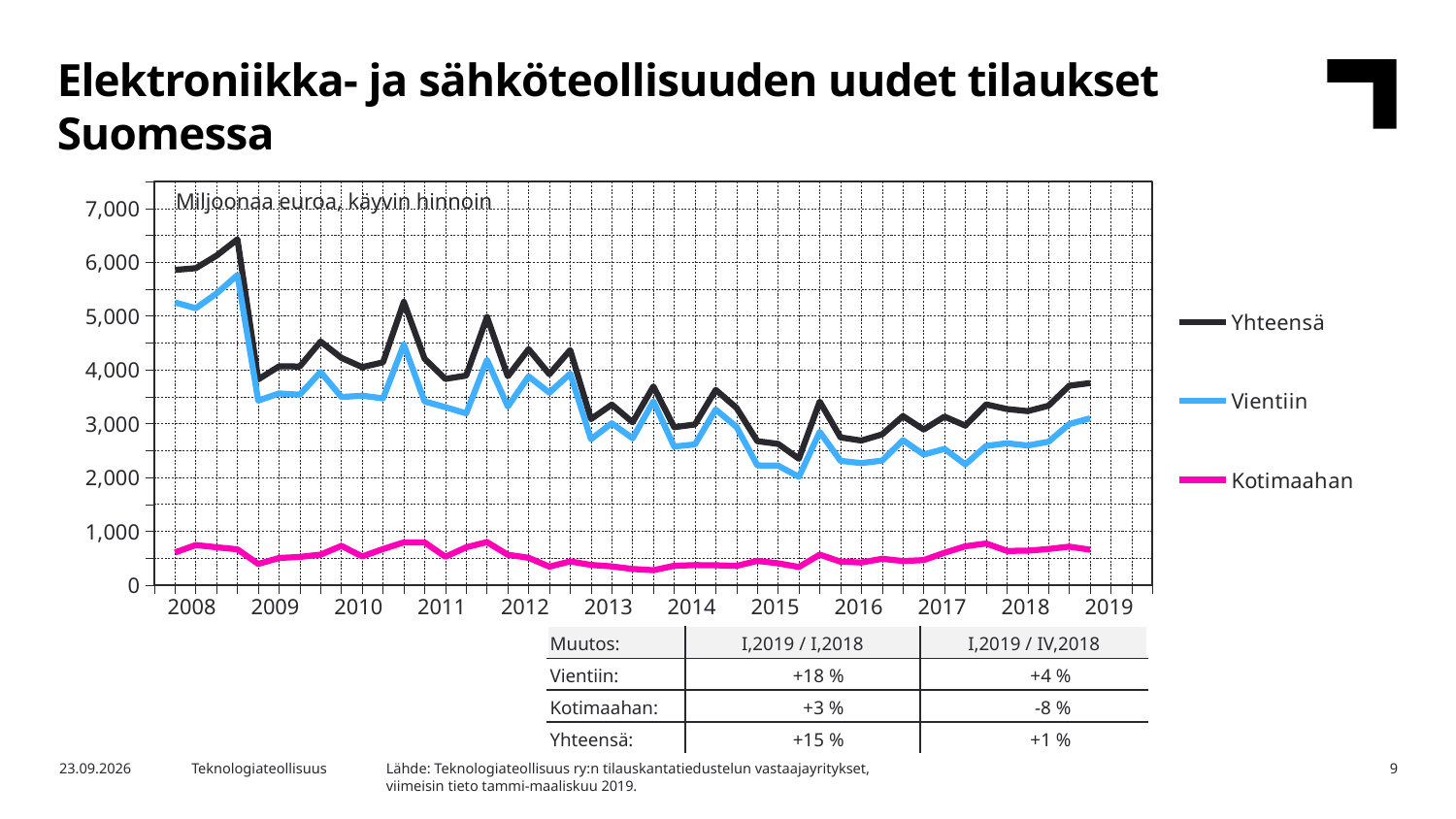
How many series does the chart legend list? 3 Which series has the lowest values throughout the chart? Kotimaahan What kind of chart is shown on the slide? line chart Which is larger in 2018, the value for Vientiin or the value for Kotimaahan? Vientiin Is the value for Kotimaahan in 2013 greater or less than 1,000? less What unit is stated in the label at the top of the chart? Miljoonaa euroa, käyvin hinnoin Does the Yhteensä line overall rise or fall between 2008 and 2016? fall Is the value for Vientiin in 2016 greater or less than 3,000? less How many years are labelled on the x axis of the chart? 12 What are the three series named in the chart legend? Yhteensä, Vientiin, Kotimaahan Is the value for Yhteensä at the start of 2008 greater or less than 5,000? greater Which series has the highest values throughout the chart? Yhteensä